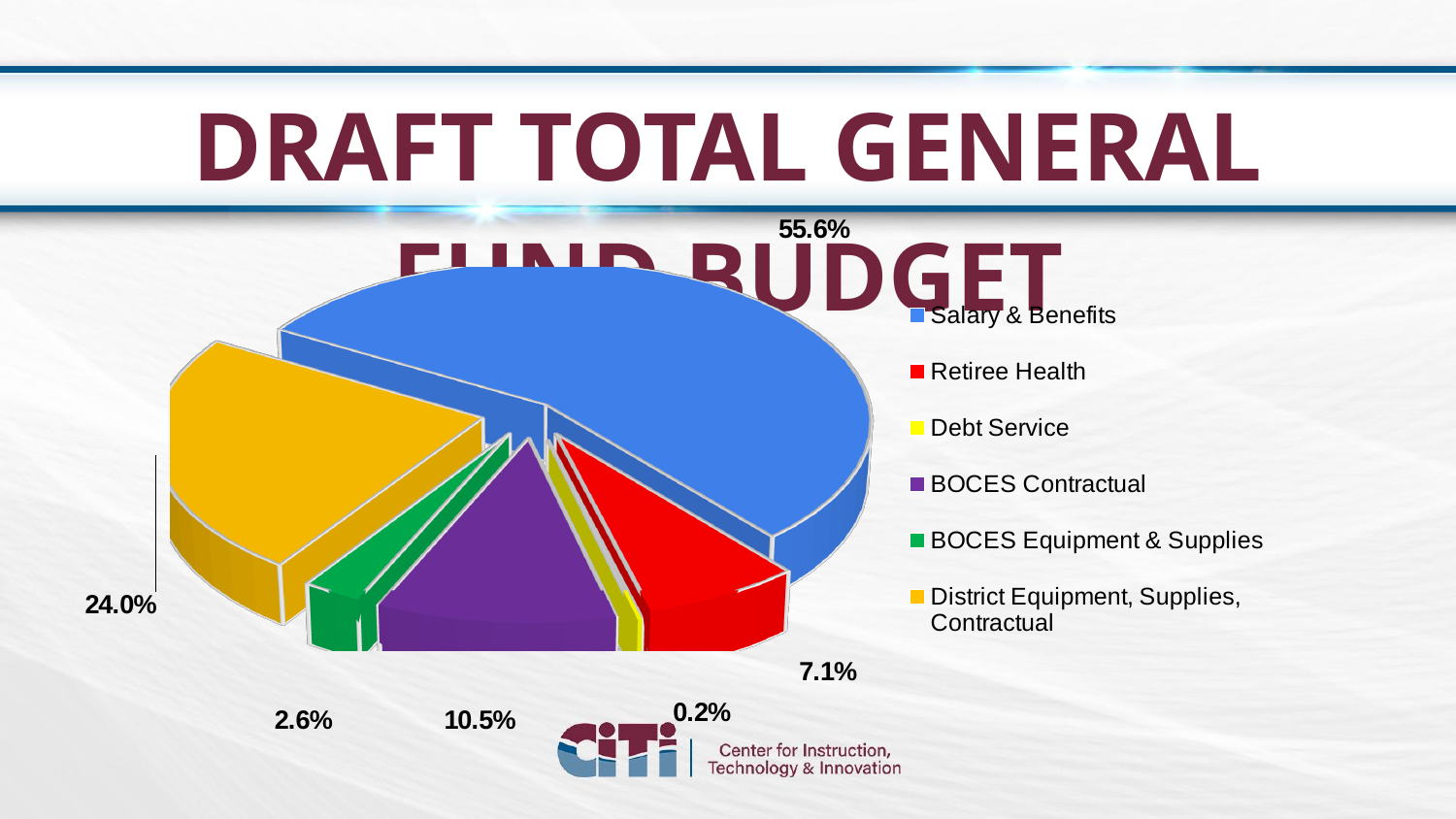
What share of the budget is BOCES Equipment & Supplies? 2.6% Which is larger, the share for BOCES Contractual or the share for Retiree Health? BOCES Contractual Which category has the largest share of the budget? Salary & Benefits What share of the budget is BOCES Contractual? 10.5% What kind of chart is shown on the slide? Pie chart Which category has the smallest share of the budget? Debt Service How many categories does the legend list? 6 What share of the budget is Debt Service? 0.2% What share of the budget is Salary & Benefits? 55.6% What share of the budget is Retiree Health? 7.1% What is the difference in percentage points between Salary & Benefits and District Equipment, Supplies, Contractual? 31.6 What share of the budget is District Equipment, Supplies, Contractual? 24.0%